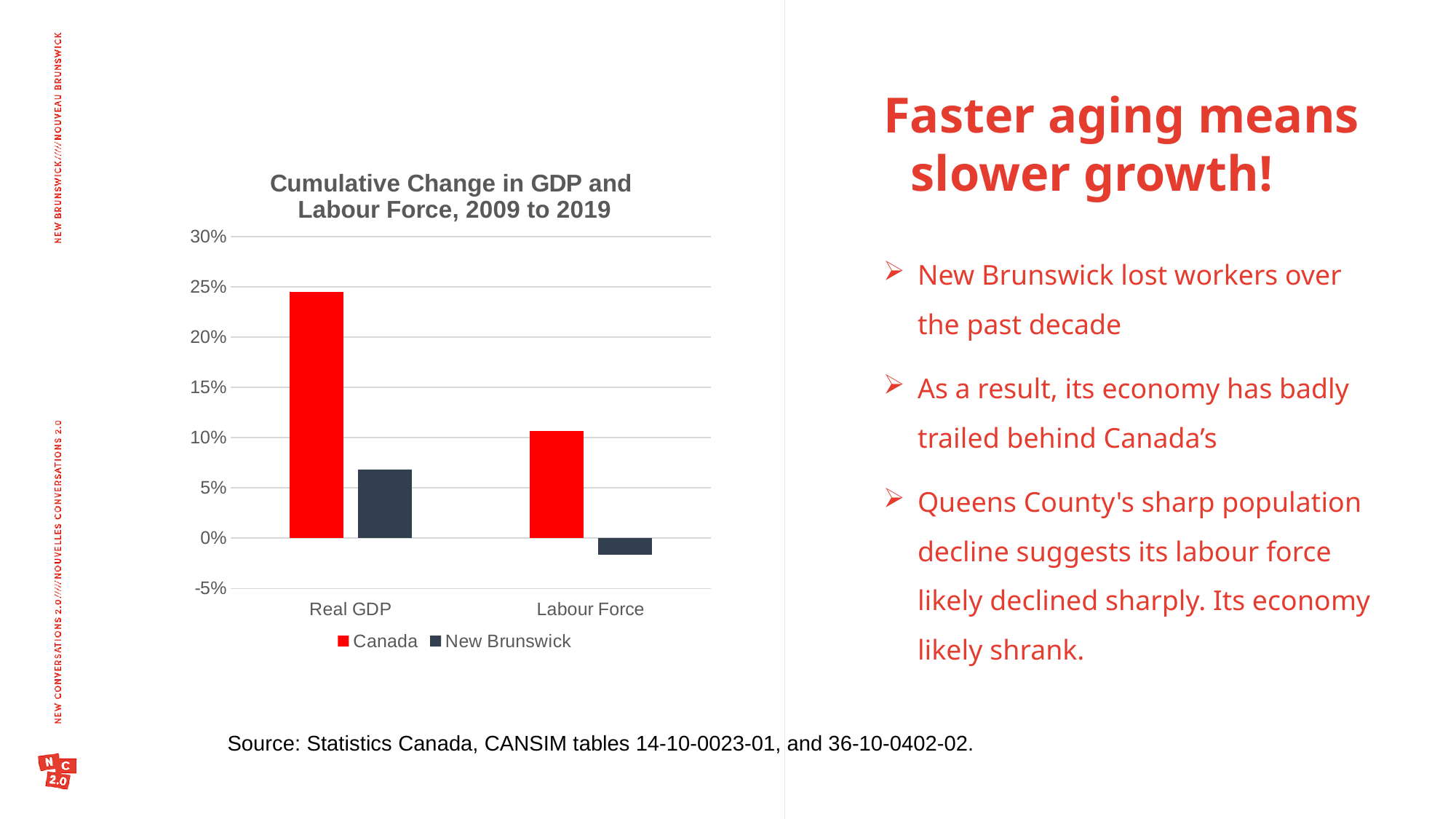
Is the New Brunswick value for Labour Force greater or less than 0%? less For Labour Force, which is larger: the Canada value or the New Brunswick value? Canada Is the New Brunswick value for Real GDP greater or less than 10%? less Is the Canada value for Real GDP greater or less than 20%? greater Which bar is the lowest in the chart? New Brunswick, Labour Force Which series is shown in red? Canada What is the title of the chart? Cumulative Change in GDP and Labour Force, 2009 to 2019 How many categories are shown on the x axis? 2 Which bar is the highest in the chart? Canada, Real GDP How many series does the legend list? 2 What kind of chart is shown on the slide? bar chart